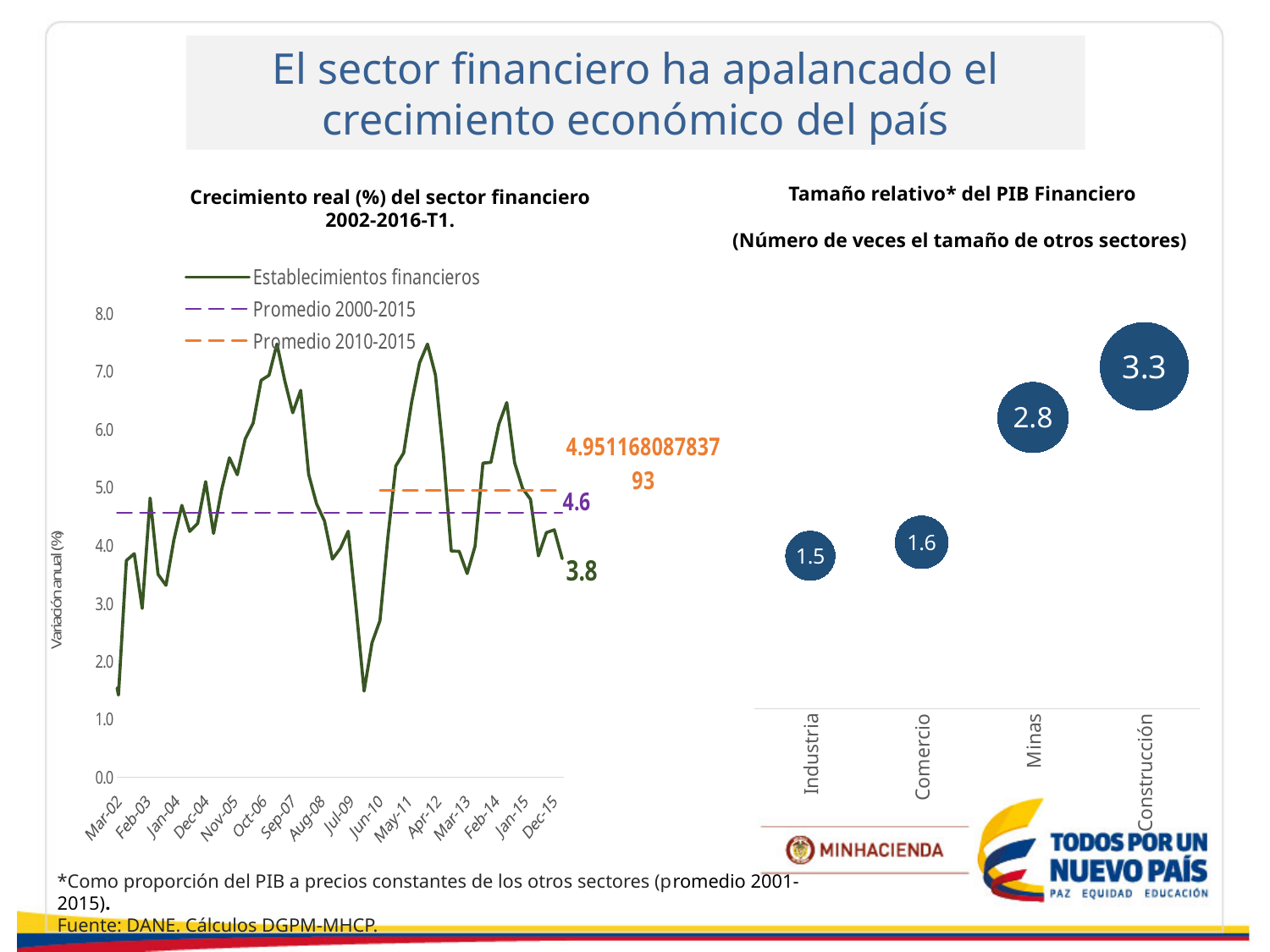
What type of chart is 'Crecimiento real (%) del sector financiero 2002-2016-T1.'? Line chart In the chart 'Crecimiento real (%) del sector financiero 2002-2016-T1.', what is the last labelled value of the Establecimientos financieros series? 3.8 In the chart 'Tamaño relativo* del PIB Financiero', what is the value for Construcción? 3.3 In the chart 'Tamaño relativo* del PIB Financiero', what is the value for Minas? 2.8 In the chart 'Tamaño relativo* del PIB Financiero', which sector has the lowest value? Industria How many series does the legend of the chart 'Crecimiento real (%) del sector financiero 2002-2016-T1.' list? 3 In the chart 'Tamaño relativo* del PIB Financiero', which sector has the highest value? Construcción In the chart 'Tamaño relativo* del PIB Financiero', what is the difference between the values for Construcción and Minas? 0.5 How many sectors are shown in the chart 'Tamaño relativo* del PIB Financiero'? 4 In the chart 'Crecimiento real (%) del sector financiero 2002-2016-T1.', what value is labelled for the Promedio 2000-2015 line? 4.6 In the chart 'Tamaño relativo* del PIB Financiero', which is larger, the value for Comercio or the value for Industria? Comercio In the chart 'Tamaño relativo* del PIB Financiero', what is the value for Industria? 1.5